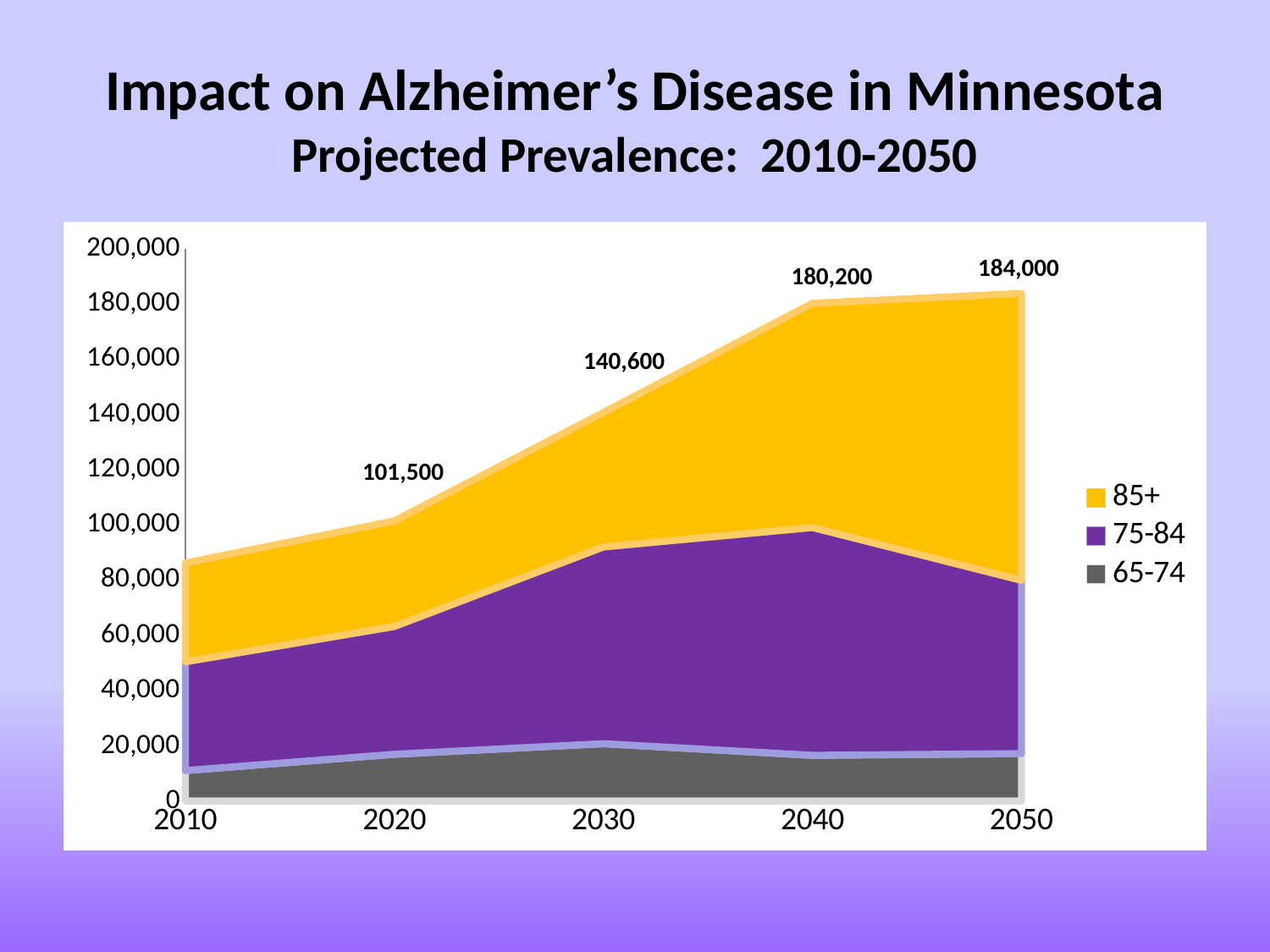
What is the total projected prevalence labelled for 2040? 180,200 What is the total projected prevalence labelled for 2050? 184,000 What kind of chart is shown on the slide? Stacked area chart Which year has the highest labelled total projected prevalence? 2050 What is the difference between the labelled totals for 2050 and 2040? 3,800 Which year has a larger labelled total, 2020 or 2030? 2030 How many years are shown on the x axis? 5 What is the total projected prevalence labelled for 2020? 101,500 What is the total projected prevalence labelled for 2030? 140,600 What is the difference between the labelled totals for 2040 and 2030? 39,600 Is the total projected prevalence for 2010 greater or less than 100,000? less How many age groups does the legend list? 3